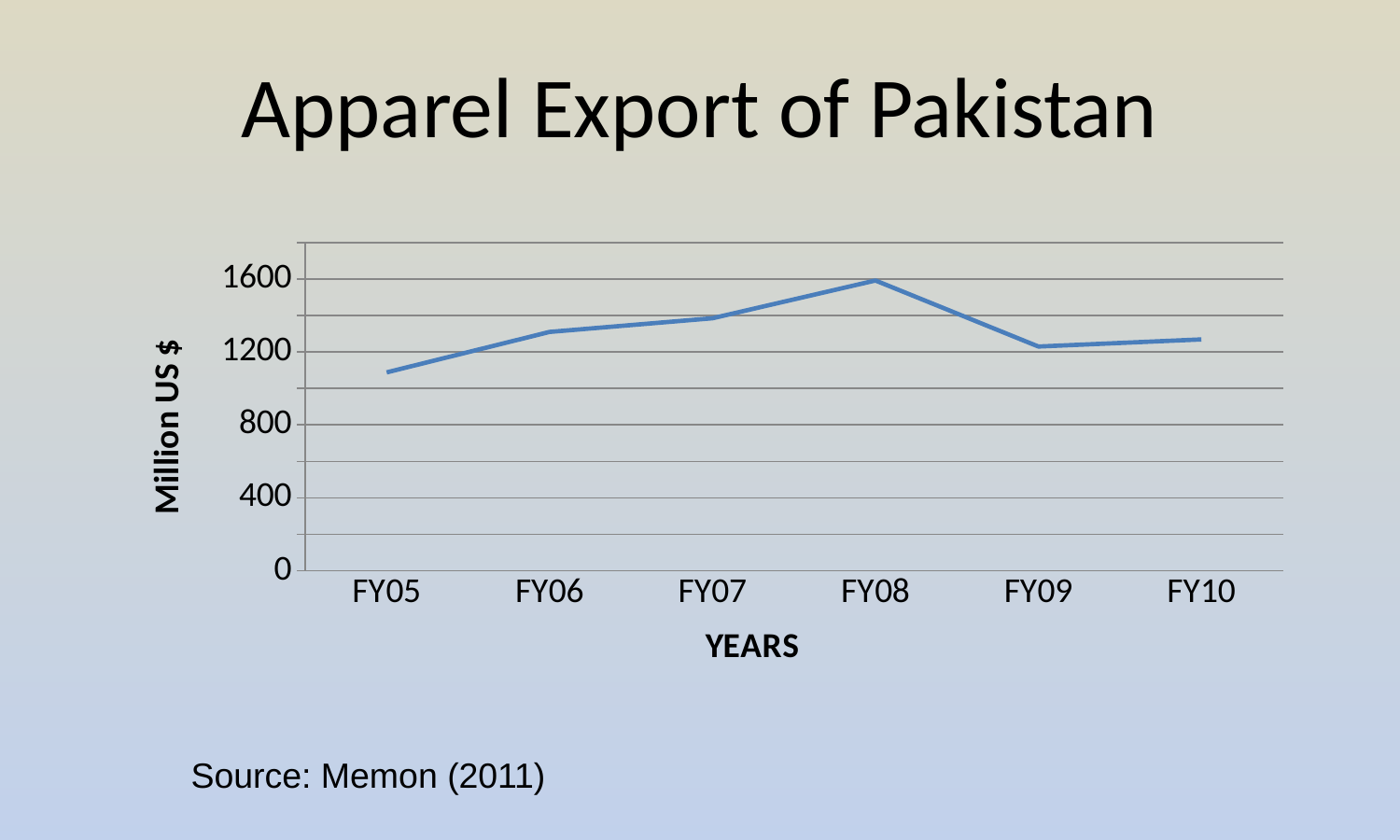
Which is larger, the value for FY08 or the value for FY09? FY08 Which is larger, the value for FY05 or the value for FY06? FY06 Which fiscal year has the highest apparel export value? FY08 Which fiscal year has the lowest apparel export value? FY05 Is the value for FY05 greater or less than 1200? less Do the values rise or fall from FY05 to FY08? rise What kind of chart is shown on the slide? line chart Is the value for FY07 greater or less than 1600? less Is the value for FY08 greater or less than 1400? greater What is the label on the vertical axis of the chart? Million US $ How many fiscal years are plotted on the x axis? 6